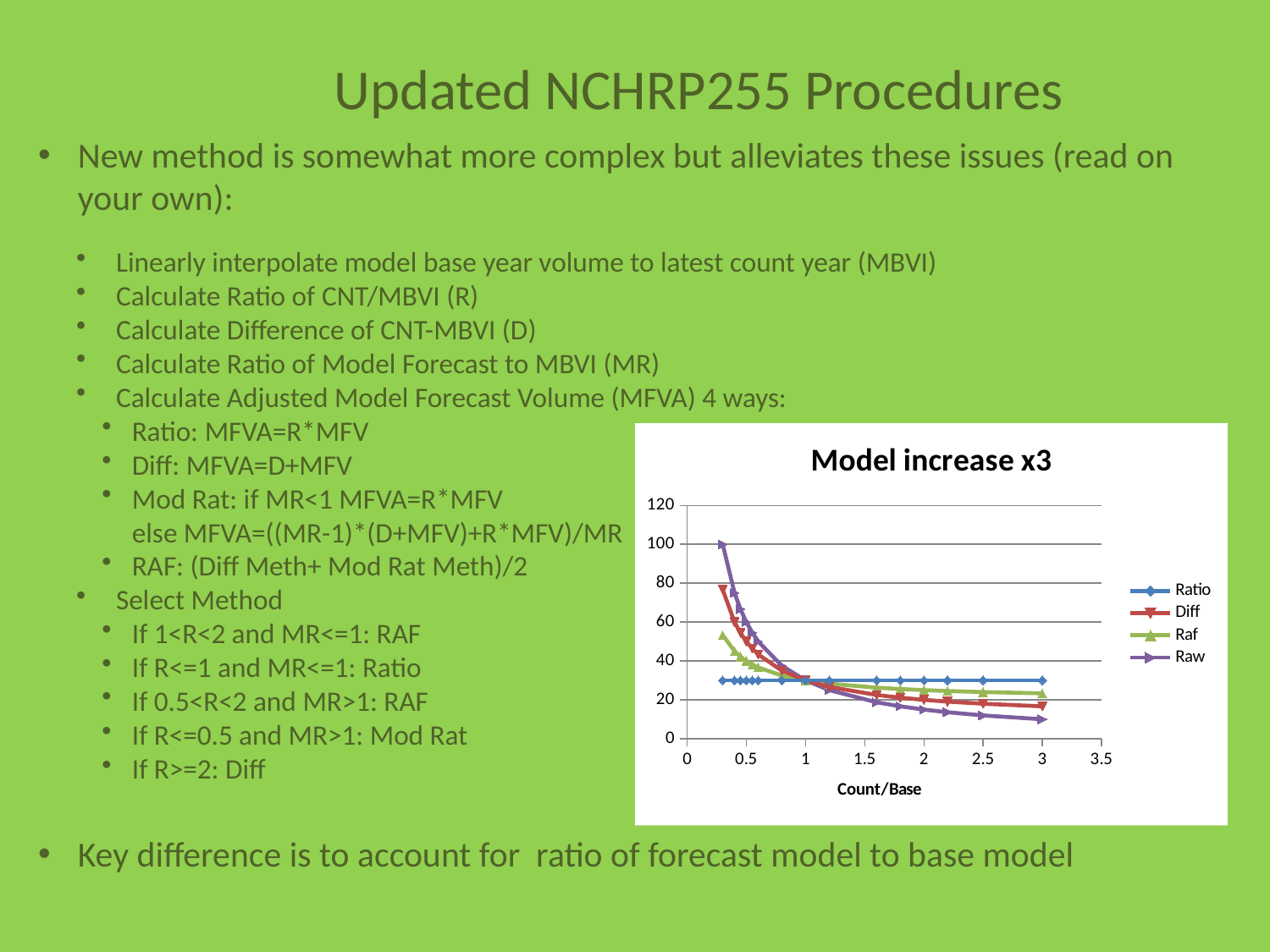
Which series has the lowest value at Count/Base = 3? Raw What is the label of the x axis of the chart? Count/Base Does the Ratio series rise, fall, or stay flat as Count/Base increases? stay flat Does the Raw series rise or fall as Count/Base increases? fall What is the title of the chart? Model increase x3 Is the value of the Ratio series at Count/Base = 2 greater or less than 20? greater How many series does the legend of the chart list? 4 Which series has the highest value at the leftmost point (Count/Base about 0.3)? Raw At Count/Base = 3, which series has the larger value, Ratio or Diff? Ratio Is the value of the Raw series at its leftmost point greater or less than 80? greater Is the value of the Raw series at Count/Base = 3 greater or less than 20? less What kind of chart is shown on the slide? line chart